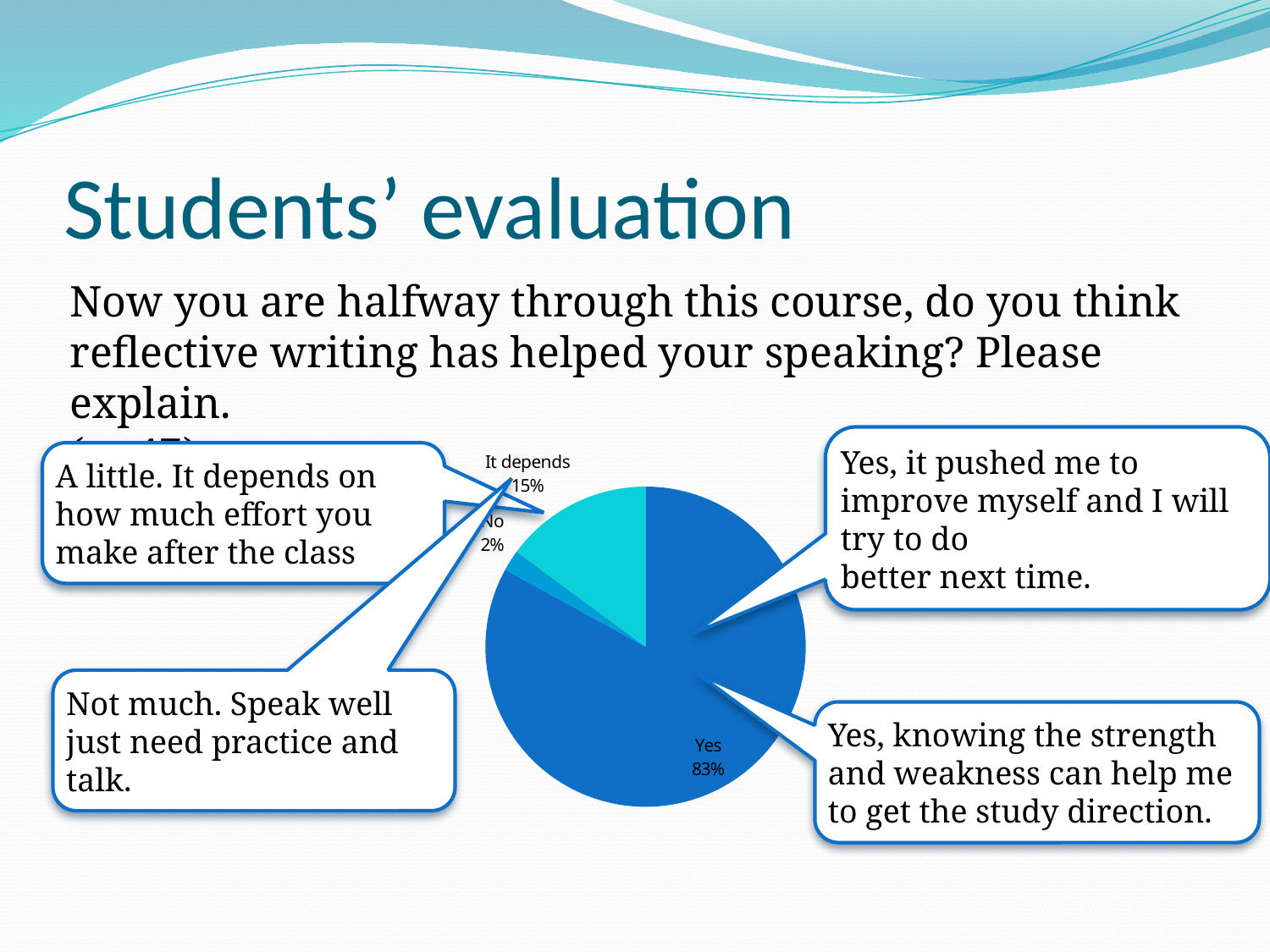
What colour is the "It depends" slice of the pie chart? Light blue (cyan) By how many percentage points does "Yes" exceed "It depends"? 68 percentage points Which response has the smallest share of the pie chart? No Which response has the largest share of the pie chart? Yes What percentage of students answered "It depends"? 15% What percentage of students answered "Yes" in the pie chart? 83% How many slices does the pie chart have? 3 Which is larger: the share for "It depends" or the share for "No"? It depends By how many percentage points does "It depends" exceed "No"? 13 percentage points What type of chart is shown on the slide? Pie chart What share of the pie does the "Yes" slice take up? 83% What percentage of students answered "No"? 2%